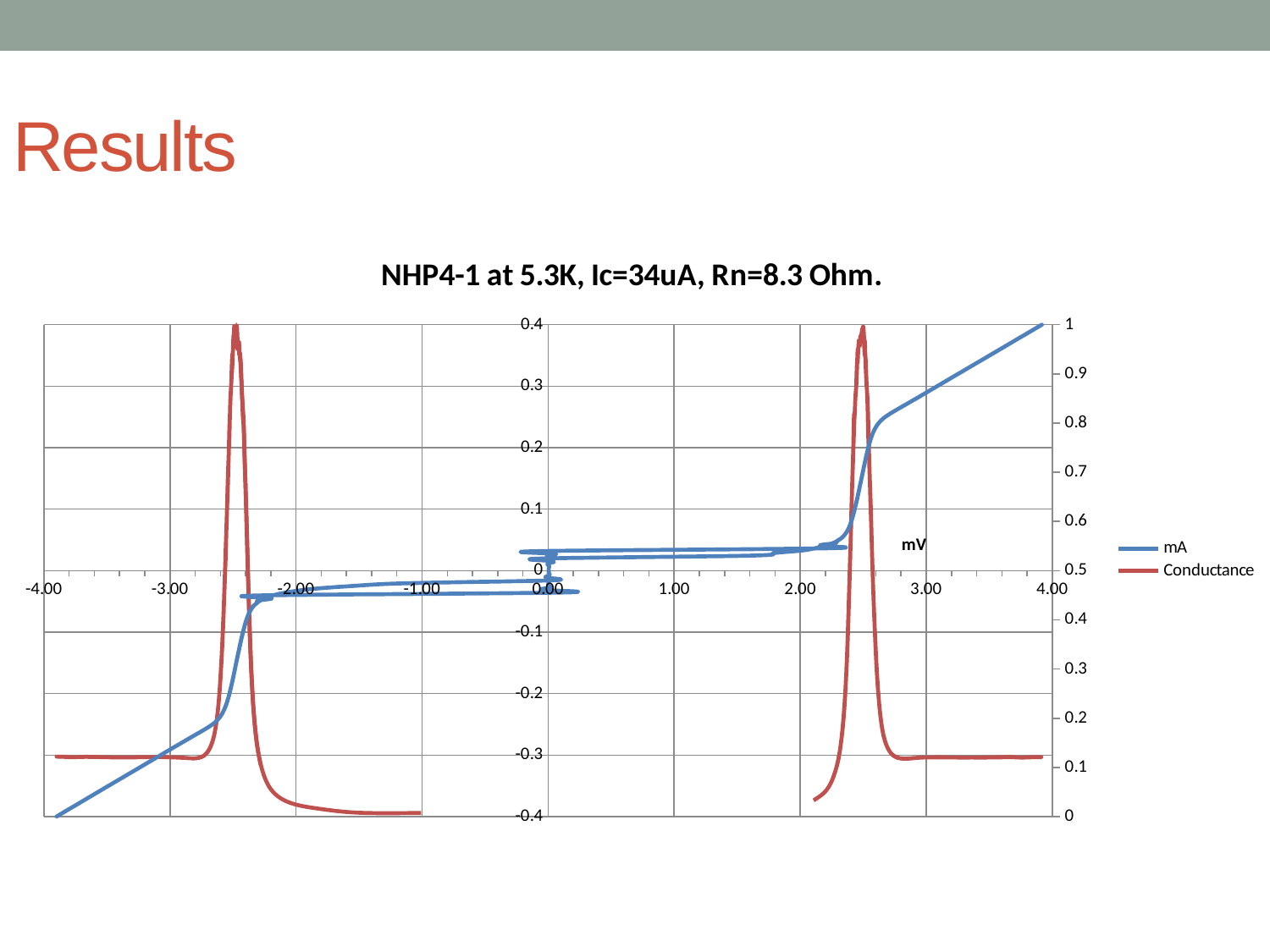
Does the mA series overall rise or fall as the x axis goes from -4.00 to 4.00 mV? rise Which is larger, the Conductance value at 2.50 mV or at 3.50 mV? 2.50 mV Is the mA value at -3.00 mV greater or less than -0.2? less What kind of chart is shown on the slide? line chart Is the mA value at 3.00 mV greater or less than 0.2? greater Is the peak Conductance value near 2.50 mV greater or less than 0.9 on the right axis? greater What is the title of the chart? NHP4-1 at 5.3K, Ic=34uA, Rn=8.3 Ohm. How many series does the legend list? 2 What are the two series named in the legend? mA and Conductance Which is larger, the mA value at 3.00 mV or the mA value at 1.00 mV? 3.00 mV